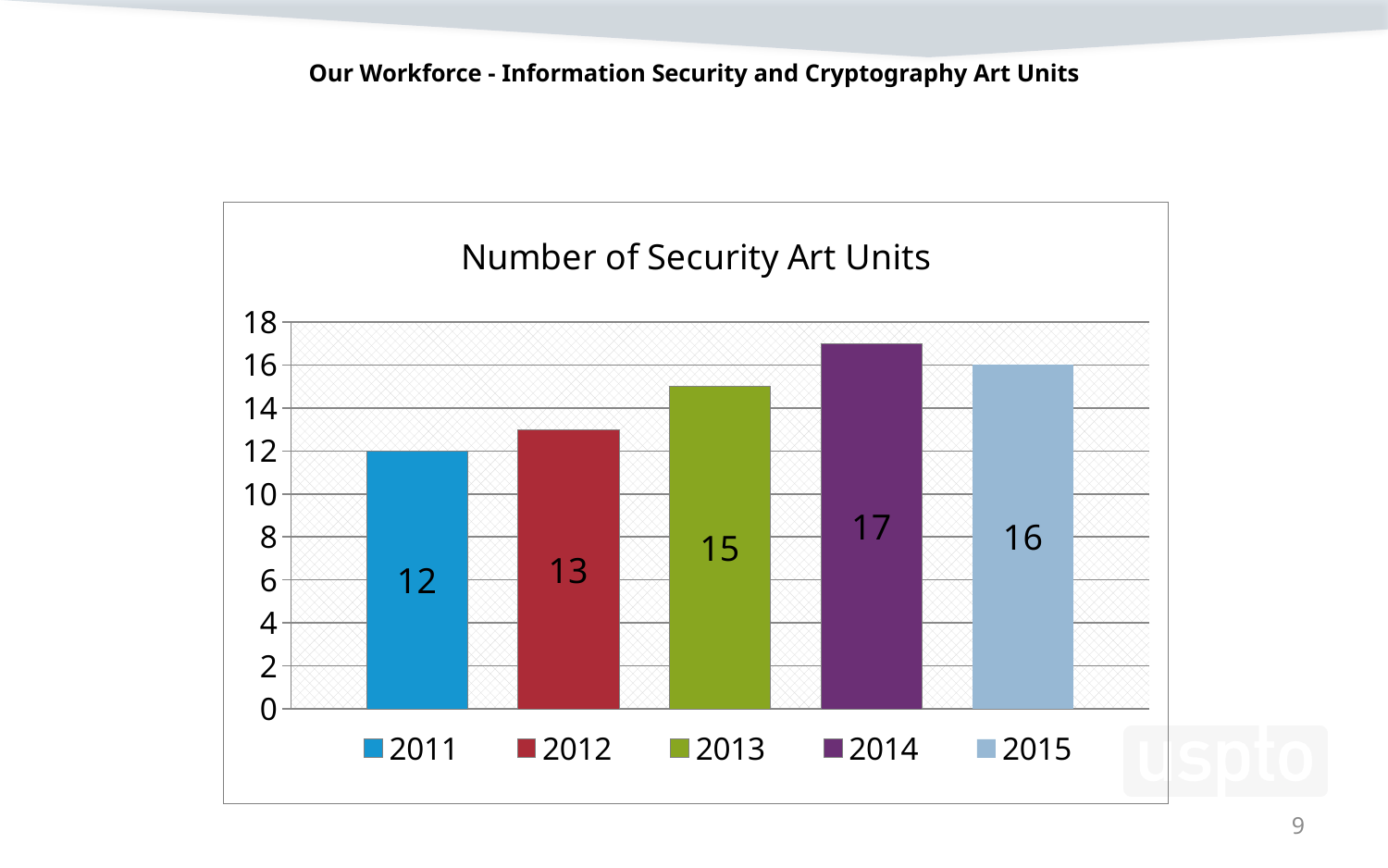
What kind of chart is shown on the slide? bar chart What is the number of security art units in 2014? 17 What is the title of the chart? Number of Security Art Units Which year has the highest number of security art units? 2014 Which year has the lowest number of security art units? 2011 What is the number of security art units in 2011? 12 Is the value for 2013 greater or less than 14? greater What is the difference between the number of security art units in 2013 and 2012? 2 What is the difference between the number of security art units in 2014 and 2011? 5 Which year has more security art units, 2014 or 2015? 2014 What is the number of security art units in 2015? 16 How many years are shown in the chart? 5